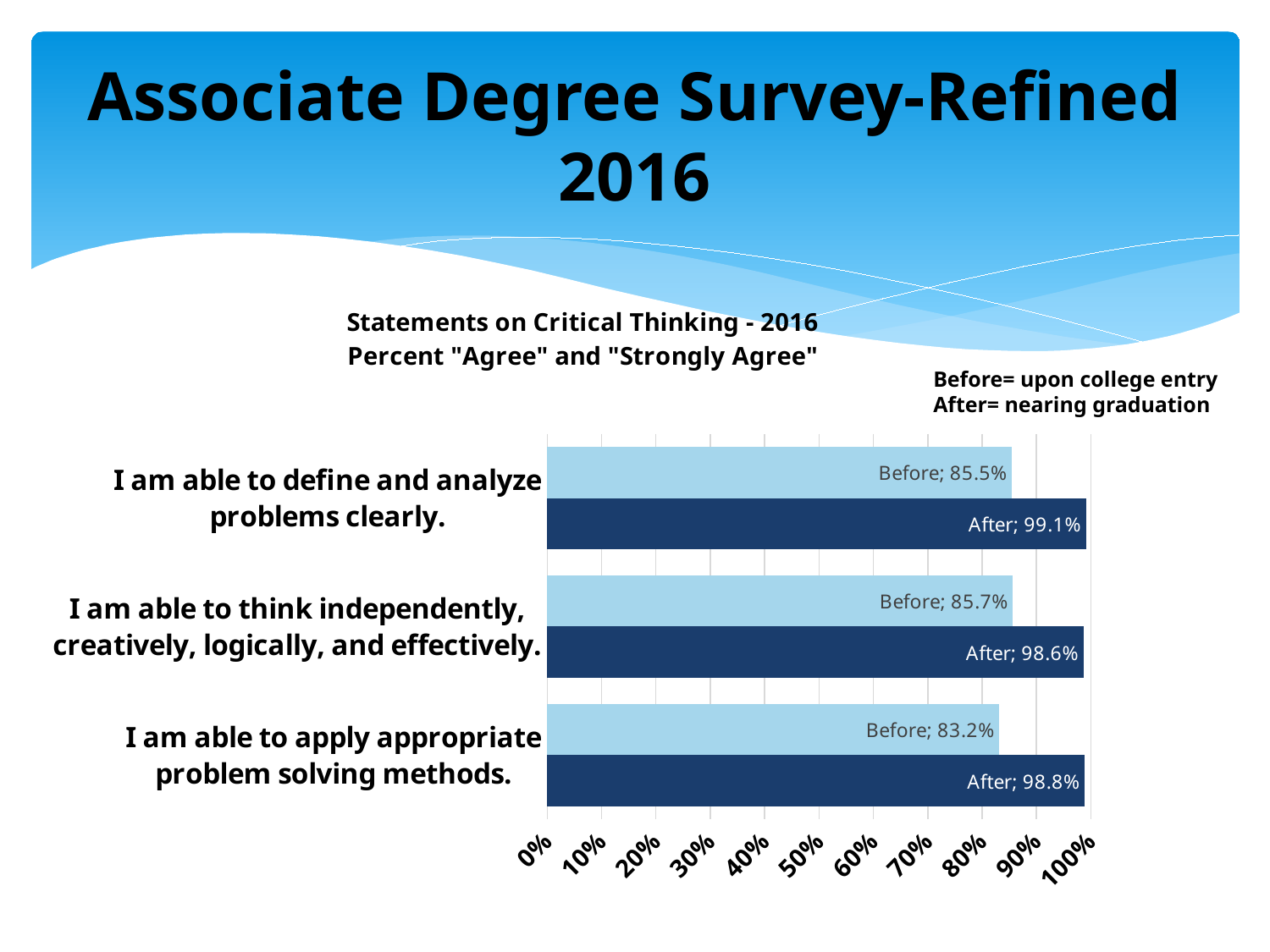
Which statement has the lowest Before value? I am able to apply appropriate problem solving methods. How many statements (categories) are plotted in the chart? 3 What is the difference between the After and Before values for "I am able to apply appropriate problem solving methods."? 15.6% What is the Before value for "I am able to apply appropriate problem solving methods."? 83.2% What kind of chart is shown on the slide? bar chart Which statement has the highest After value? I am able to define and analyze problems clearly. According to the slide, what does "Before" refer to? upon college entry What is the After value for "I am able to think independently, creatively, logically, and effectively."? 98.6% What is the chart title? Statements on Critical Thinking - 2016 Percent "Agree" and "Strongly Agree" Is the After value for "I am able to define and analyze problems clearly." greater or less than the Before value? greater How many series (Before and After) are plotted for each statement? 2 What is the Before value for "I am able to define and analyze problems clearly."? 85.5%